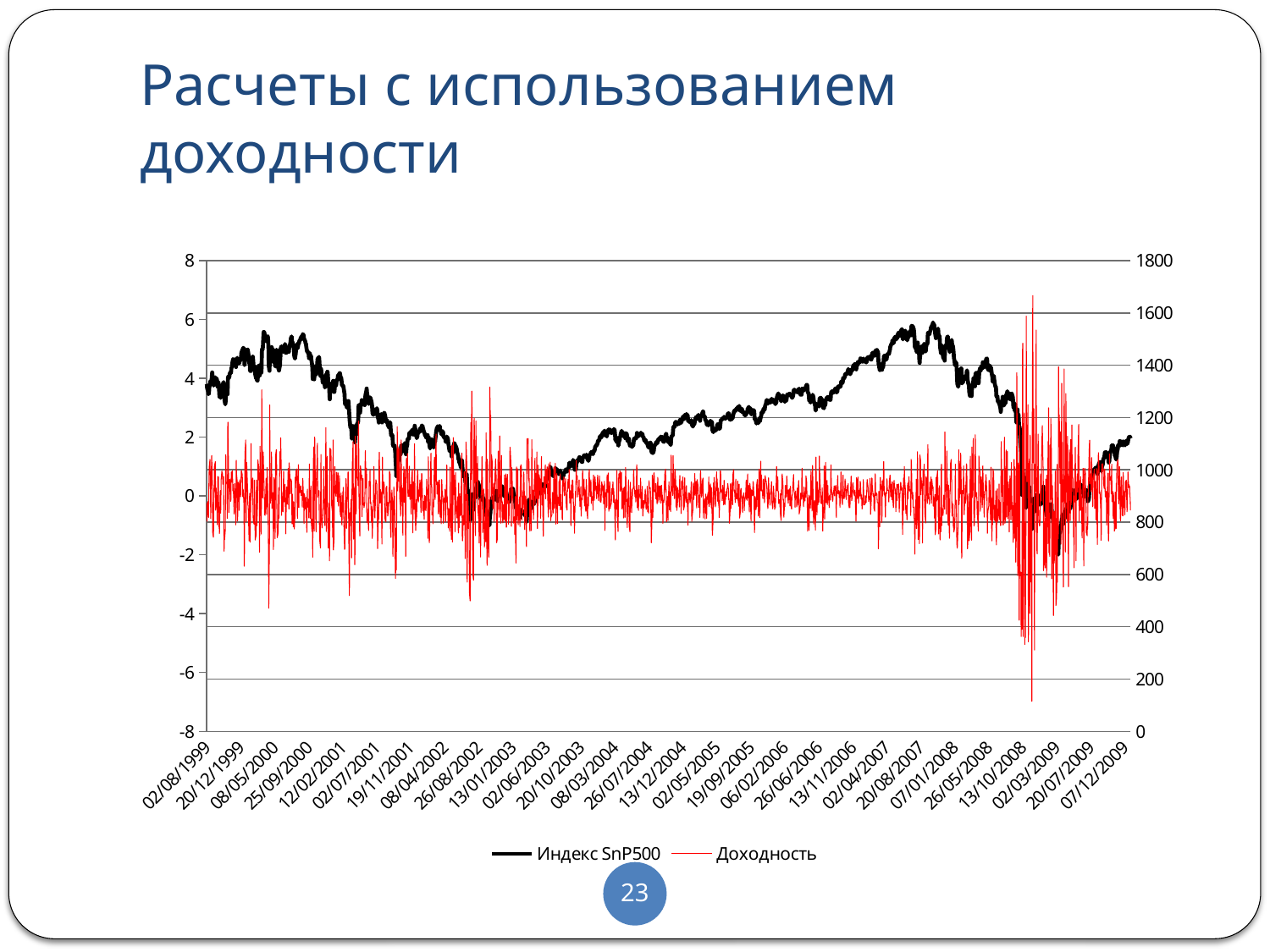
Is the value of Индекс SnP500 at 02/08/1999 greater or less than 1200? greater Which is larger: the value of Индекс SnP500 at 02/08/1999 or at 26/08/2002? 02/08/1999 How many series does the legend list? 2 Which is larger: the value of Индекс SnP500 at 20/08/2007 or at 02/08/1999? 20/08/2007 What is the maximum value shown on the right-hand vertical axis? 1800 Is the value of Индекс SnP500 at 26/08/2002 greater or less than 1000? less Does the Индекс SnP500 series rise or fall between 13/01/2003 and 20/08/2007? rise Which series is drawn in black? Индекс SnP500 Is the value of Индекс SnP500 at 20/08/2007 greater or less than 1400? greater Does the Индекс SnP500 series rise or fall between 20/08/2007 and 02/03/2009? fall What kind of chart is shown on the slide? line chart